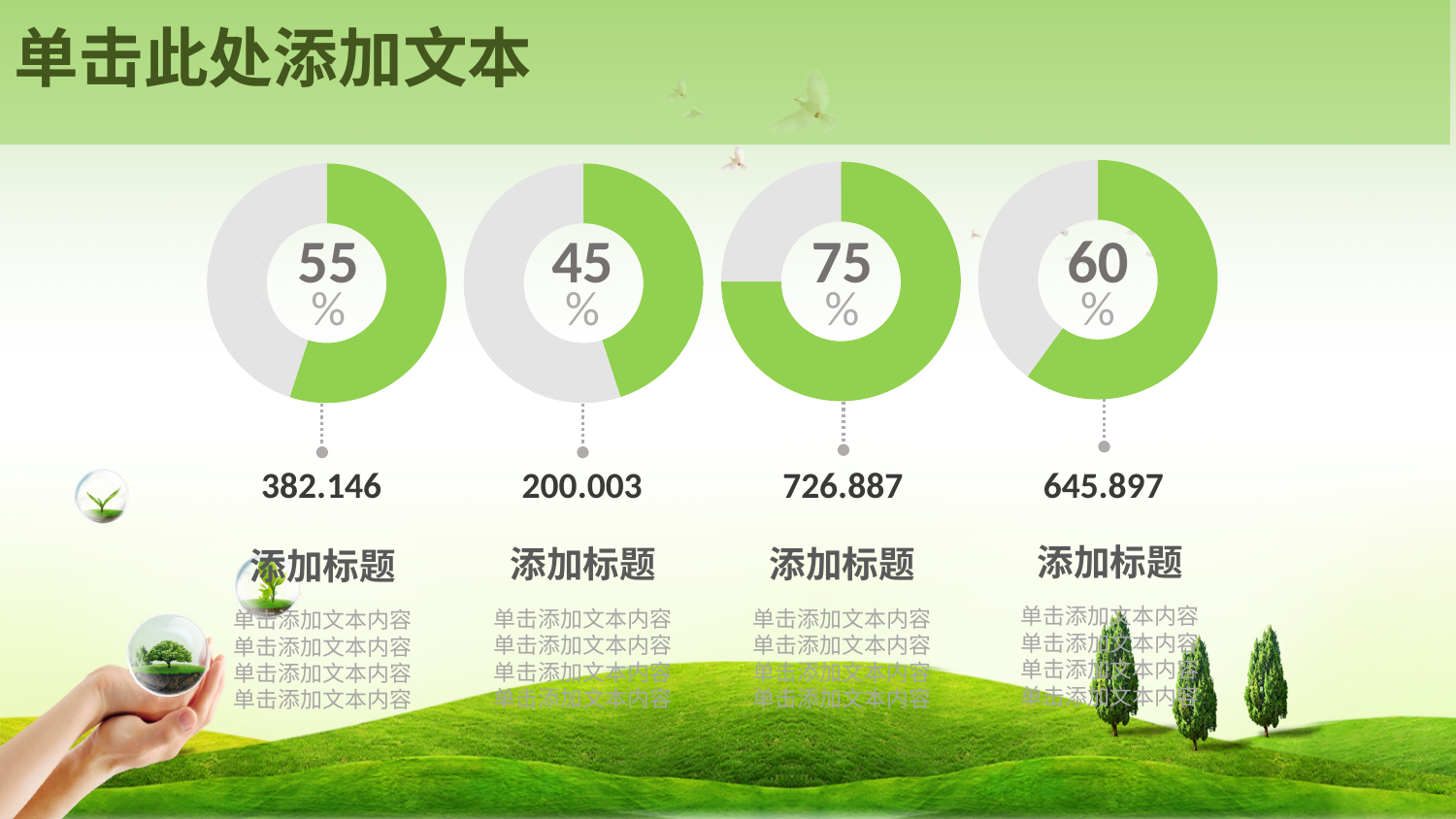
What percentage is shown in the center of the third donut chart from the left? 75% What is the difference between the percentages of the third and second donut charts? 30% Which donut chart shows the lowest percentage? The second from the left (45%) What percentage is shown in the center of the rightmost donut chart? 60% What type of chart is used on this slide? Donut chart Which donut chart shows the highest percentage? The third from the left (75%) What percentage is shown in the center of the second donut chart from the left? 45% How many donut charts are on the slide? 4 What percentage is shown in the center of the leftmost donut chart? 55% Which is larger, the percentage in the leftmost donut chart or the rightmost donut chart? The rightmost (60%) What number is printed below the leftmost donut chart? 382.146 What colour is the filled portion of each donut chart? Green